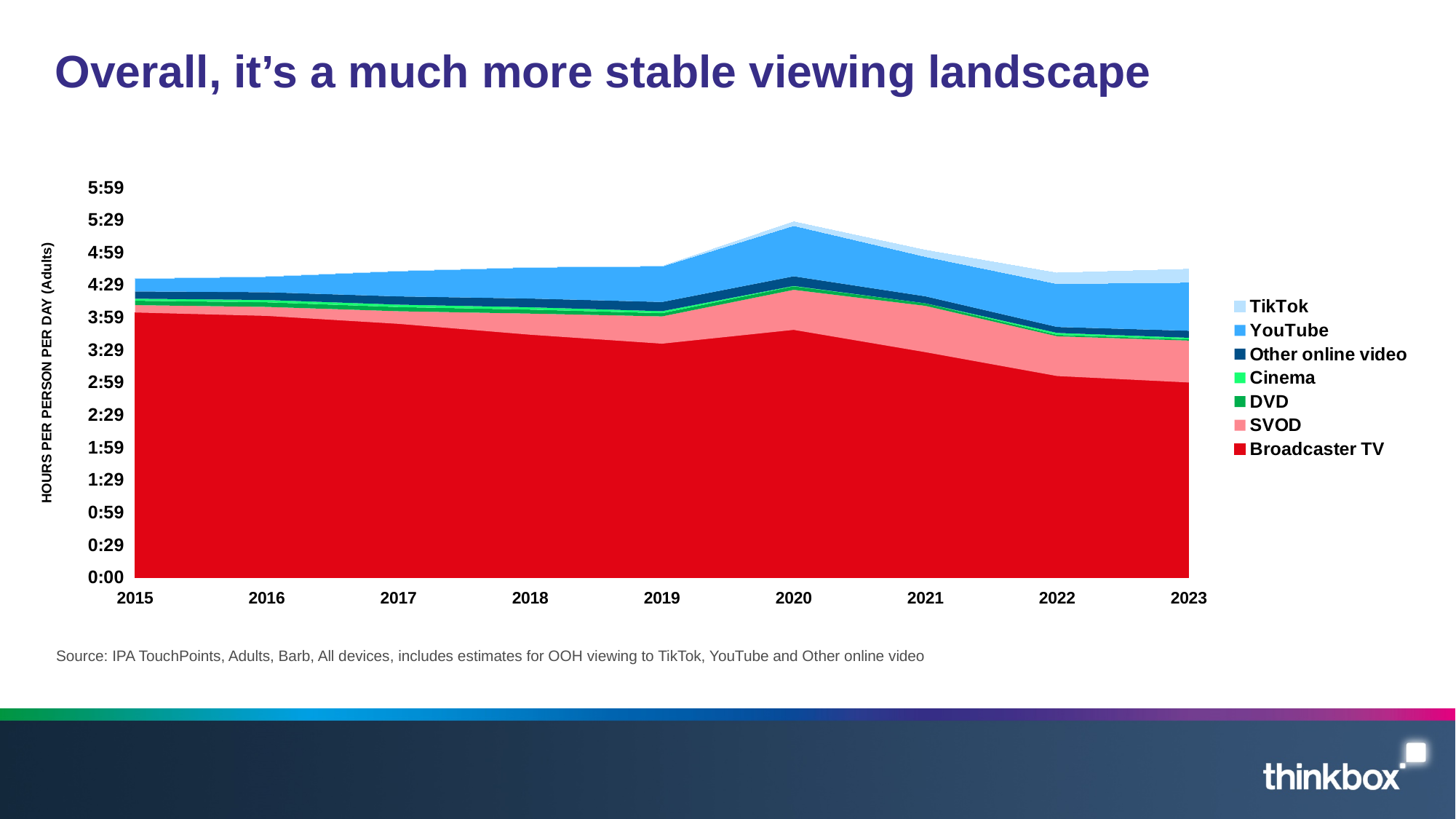
Is the total viewing time in 2015 greater or less than 4:59? less Does Broadcaster TV viewing rise or fall from 2015 to 2023? Fall In which year is the total viewing time (top of the stacked area) highest? 2020 Which series accounts for the largest share of viewing time across all years? Broadcaster TV Is the Broadcaster TV value for 2015 greater or less than 3:29? greater Is the Broadcaster TV value for 2023 greater or less than 3:29? less What kind of chart is shown on the slide? Stacked area chart How many years are plotted along the x axis? 9 What is the label on the y axis? HOURS PER PERSON PER DAY (Adults) Which is larger: Broadcaster TV viewing in 2015 or in 2023? 2015 How many series does the legend list? 7